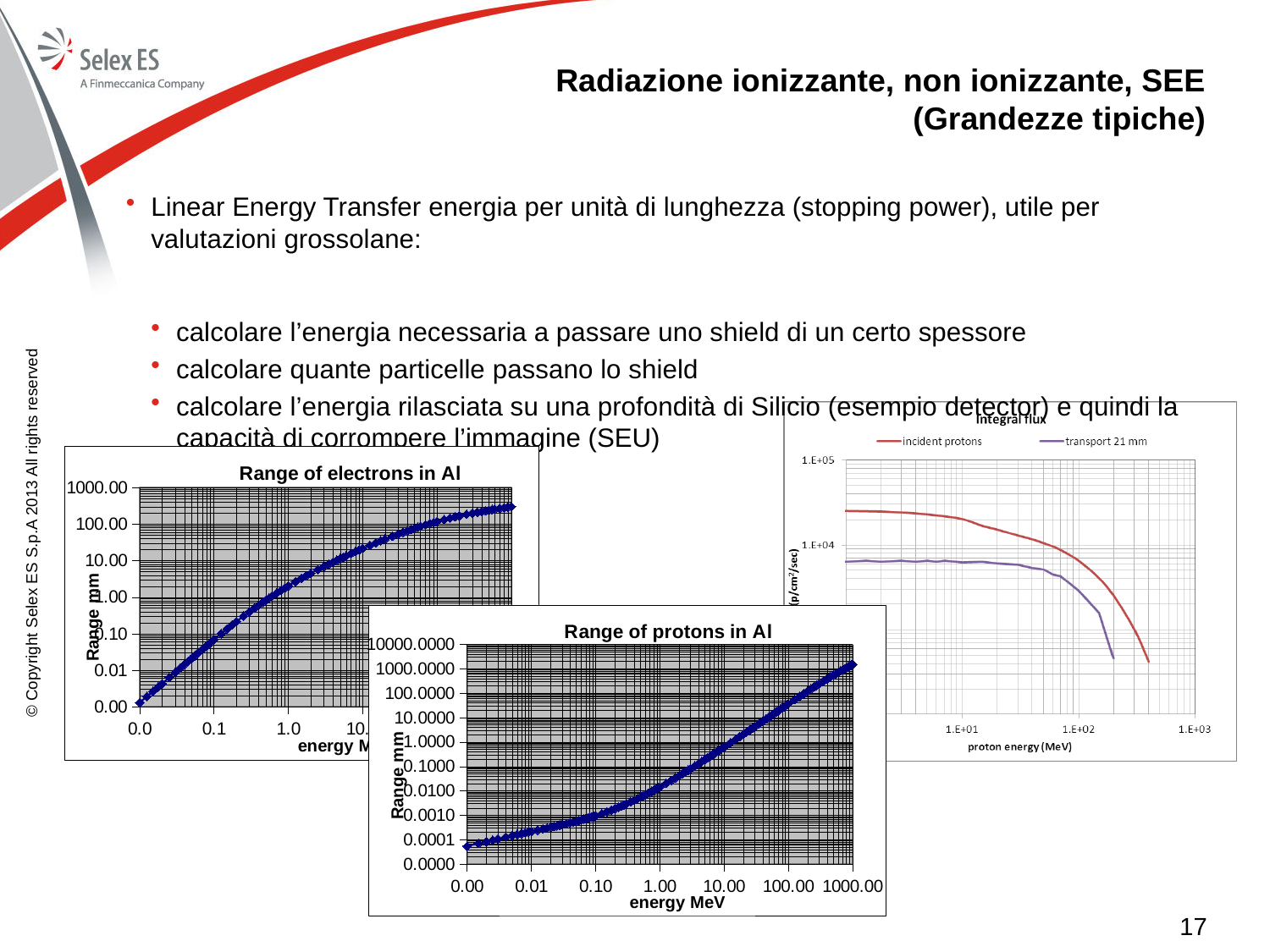
In the "Range of protons in Al" chart, is the range at 0.01 MeV greater or less than 0.0010 mm? less How many series does the legend of the "Integral flux" chart list? 2 What is the x-axis label of the "Range of protons in Al" chart? energy MeV In the "Range of electrons in Al" chart, does the range rise or fall as energy increases? rise In the "Integral flux" chart, which series has the higher values, incident protons or transport 21 mm? incident protons In the "Integral flux" chart, is the value for transport 21 mm at the lowest energies greater or less than 1.E+04? less What kind of chart is "Range of electrons in Al"? line chart In the "Integral flux" chart, is the value for incident protons at the lowest energies greater or less than 1.E+04? greater How many charts are shown on the slide? 3 In the "Integral flux" chart, do the values rise or fall as proton energy increases? fall In the "Range of protons in Al" chart, does the range rise or fall as energy increases? rise What are the two legend entries of the "Integral flux" chart? incident protons, transport 21 mm